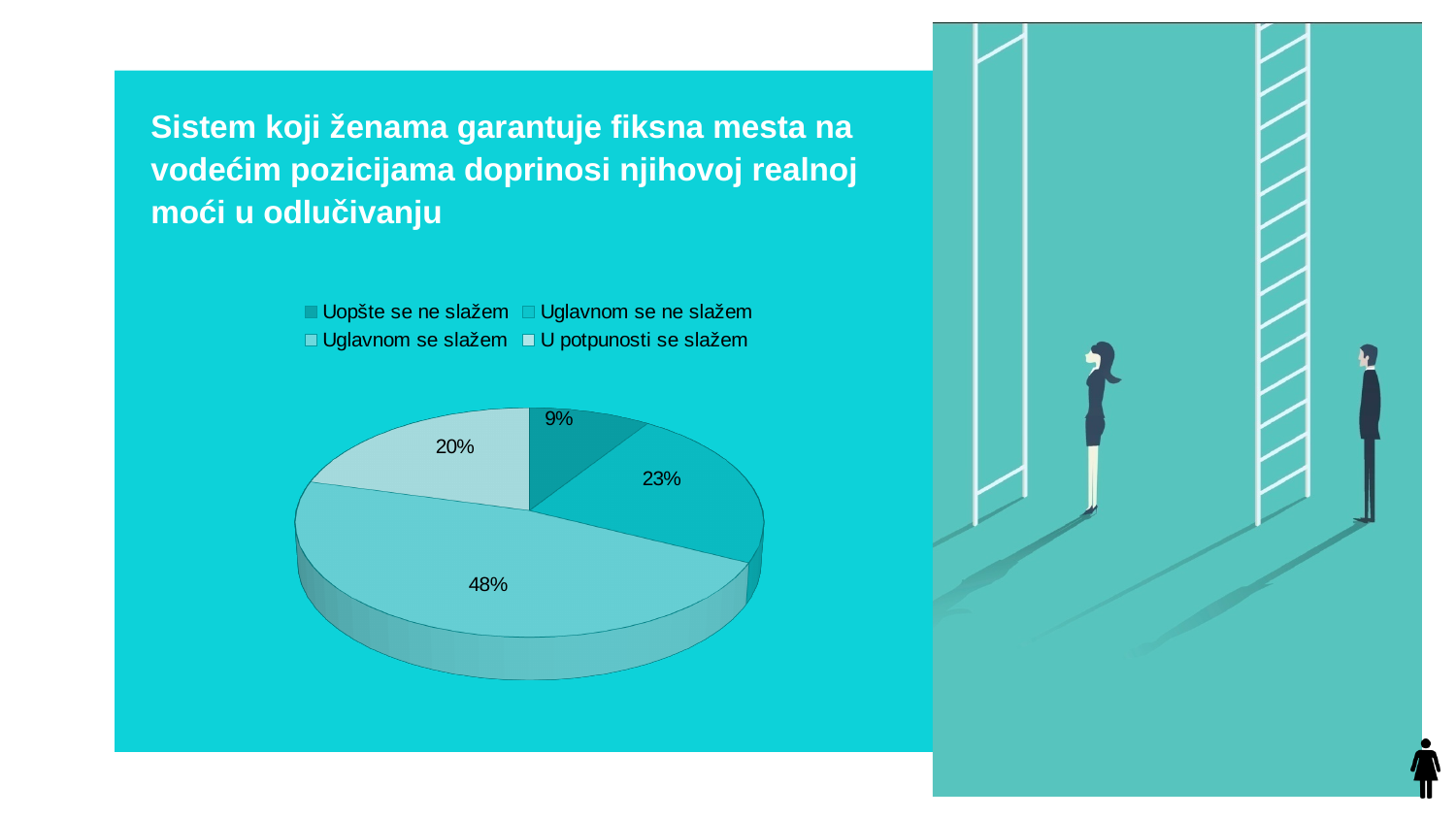
Which response category has the smallest share of the pie? Uopšte se ne slažem What kind of chart is shown on the slide? pie chart What is the difference in percentage points between "Uglavnom se slažem" and "Uglavnom se ne slažem"? 25 What percentage of respondents answered "U potpunosti se slažem"? 20% What percentage of respondents answered "Uglavnom se slažem"? 48% Which is larger: the share for "Uglavnom se ne slažem" or the share for "U potpunosti se slažem"? Uglavnom se ne slažem How many slices does the pie chart have? 4 What percentage of respondents answered "Uopšte se ne slažem"? 9% What is the combined share of "Uglavnom se slažem" and "U potpunosti se slažem"? 68% Which response category has the largest share of the pie? Uglavnom se slažem How many entries does the chart legend list? 4 What percentage of respondents answered "Uglavnom se ne slažem"? 23%